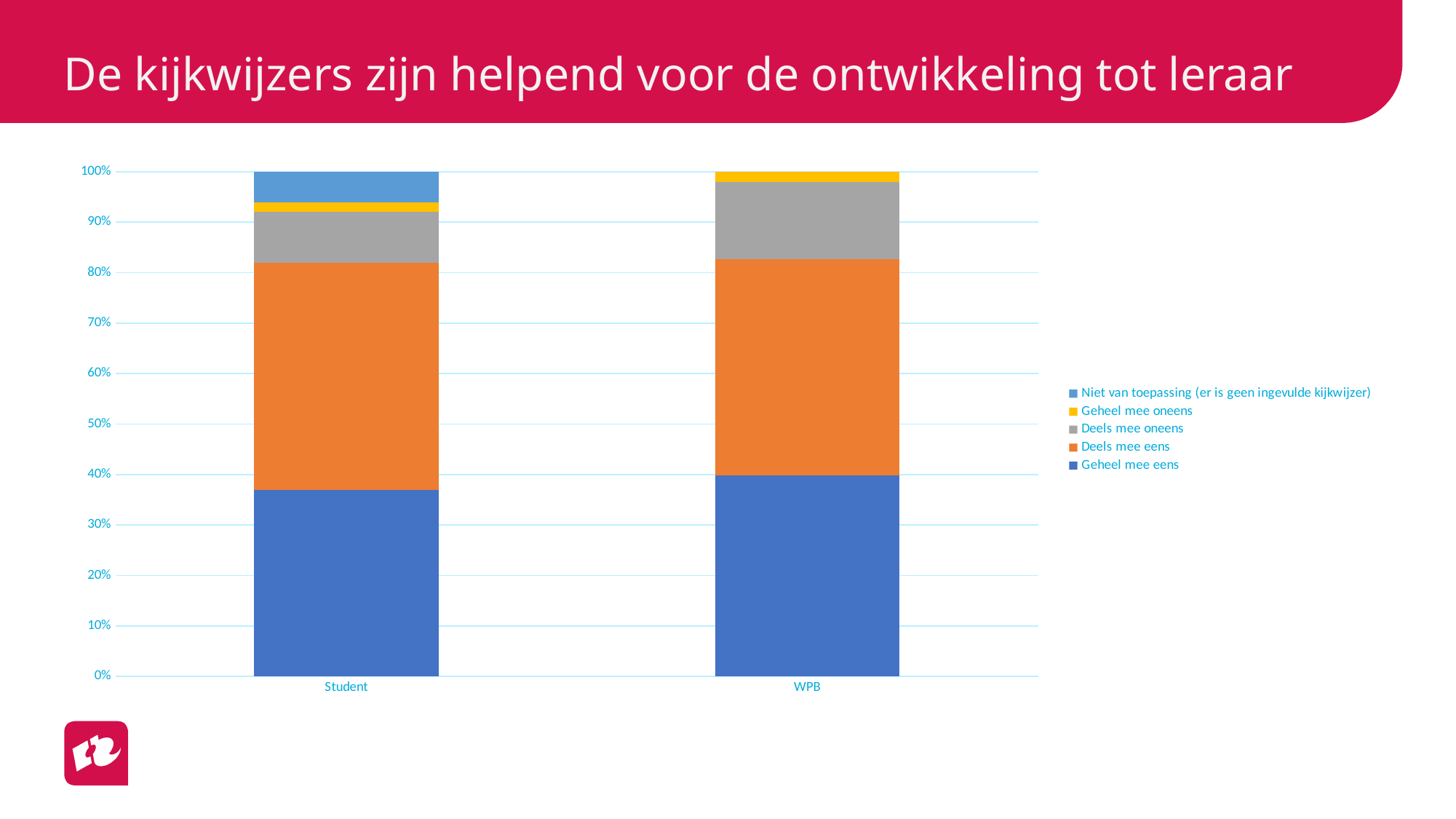
Which category has the larger 'Geheel mee eens' share, Student or WPB? WPB What kind of chart is shown on the slide? Stacked bar chart Which category has the larger 'Deels mee oneens' share, Student or WPB? WPB What is the title of the slide containing the chart? De kijkwijzers zijn helpend voor de ontwikkeling tot leraar How many series does the chart's legend list? 5 Is the cumulative top of the 'Deels mee eens' segment for Student greater or less than 80%? greater Is the 'Geheel mee eens' value for Student greater or less than 40%? less Is the 'Geheel mee eens' value for Student greater or less than 30%? greater Which legend entry is shown in orange? Deels mee eens Which category has the larger 'Niet van toepassing (er is geen ingevulde kijkwijzer)' share, Student or WPB? Student What is the total of the stacked bar for WPB? 100% How many categories are shown on the x axis of the chart? 2